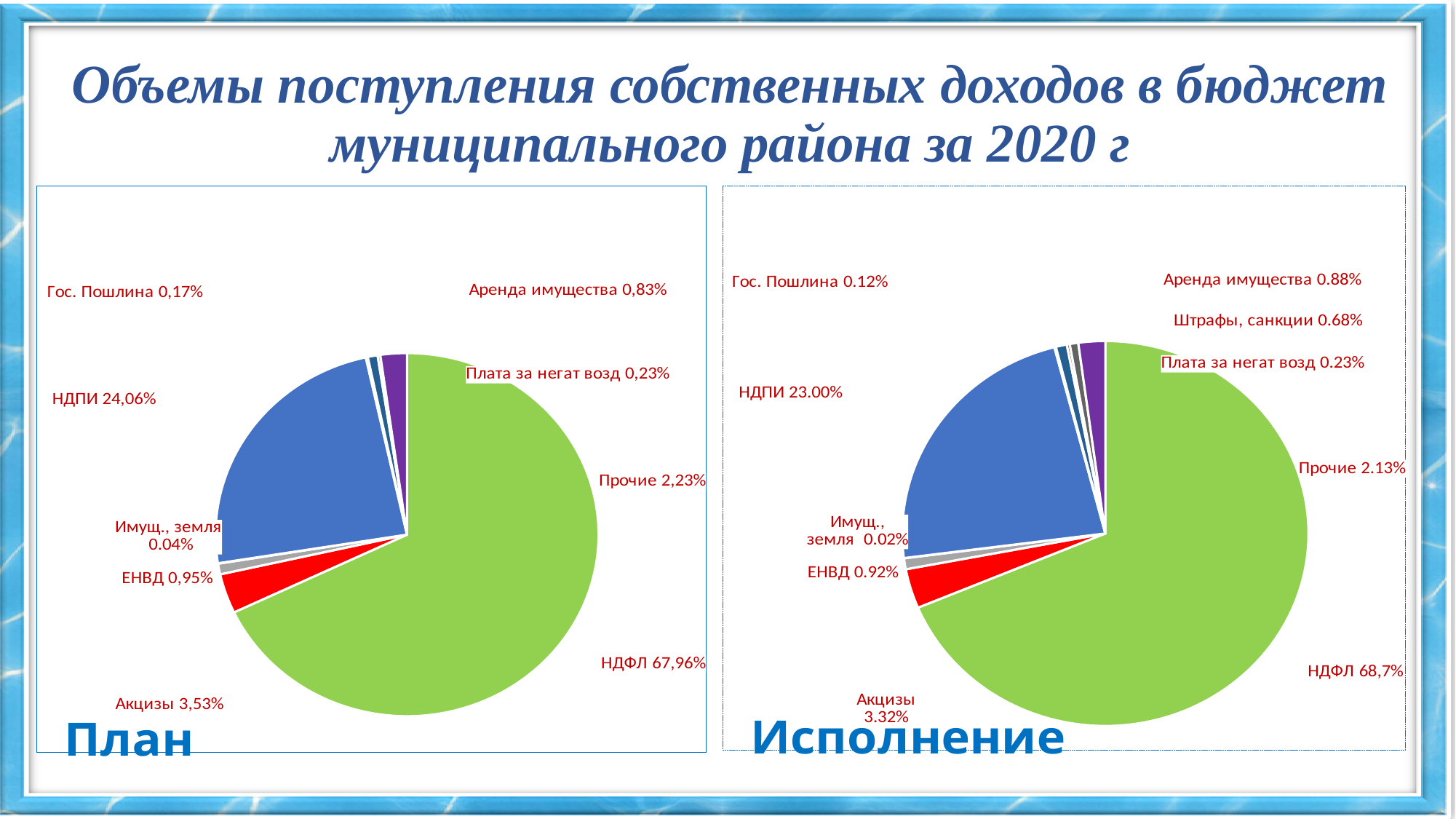
In the План chart, what is the value for Акцизы? 3,53% In the План chart, what share does НДФЛ have? 67,96% In the План chart, what is the value for ЕНВД? 0,95% What are the captions of the left and right charts? План and Исполнение In the Исполнение chart, what share does НДПИ have? 23.00% In the План chart, which category has the smallest share? Имущ., земля In the Исполнение chart, which is larger: Акцизы or Прочие? Акцизы In the Исполнение chart, which category has the largest share? НДФЛ In the Исполнение chart, what is the value for Штрафы, санкции? 0.68% What kind of charts are shown on the slide? Pie charts In the Исполнение chart, what is the difference between Акцизы and Прочие? 1.19 percentage points In the Исполнение chart, what is the value for Гос. Пошлина? 0.12%